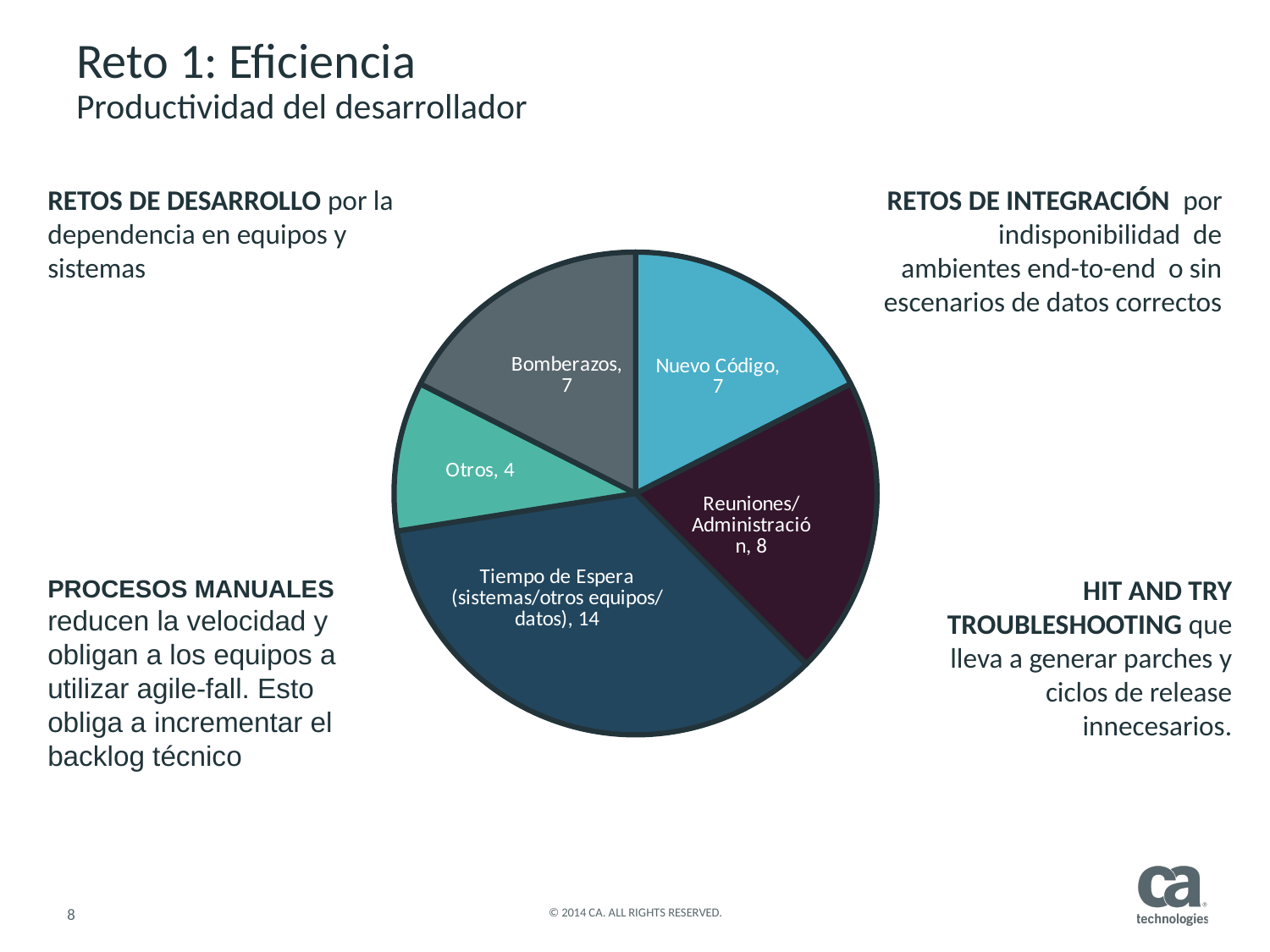
Which is larger, Reuniones/Administración or Nuevo Código? Reuniones/Administración What kind of chart is shown on the slide? pie chart Which slice of the pie chart is the largest? Tiempo de Espera (sistemas/otros equipos/datos) What is the value for Tiempo de Espera (sistemas/otros equipos/datos)? 14 What share of the pie does Otros represent? 10% What is the value for Otros? 4 Which slice of the pie chart is the smallest? Otros How many slices does the pie chart have? 5 What share of the pie does Tiempo de Espera (sistemas/otros equipos/datos) represent? 35% What is the value for Bomberazos? 7 What is the value for Reuniones/Administración? 8 What is the difference between the values for Tiempo de Espera (sistemas/otros equipos/datos) and Otros? 10